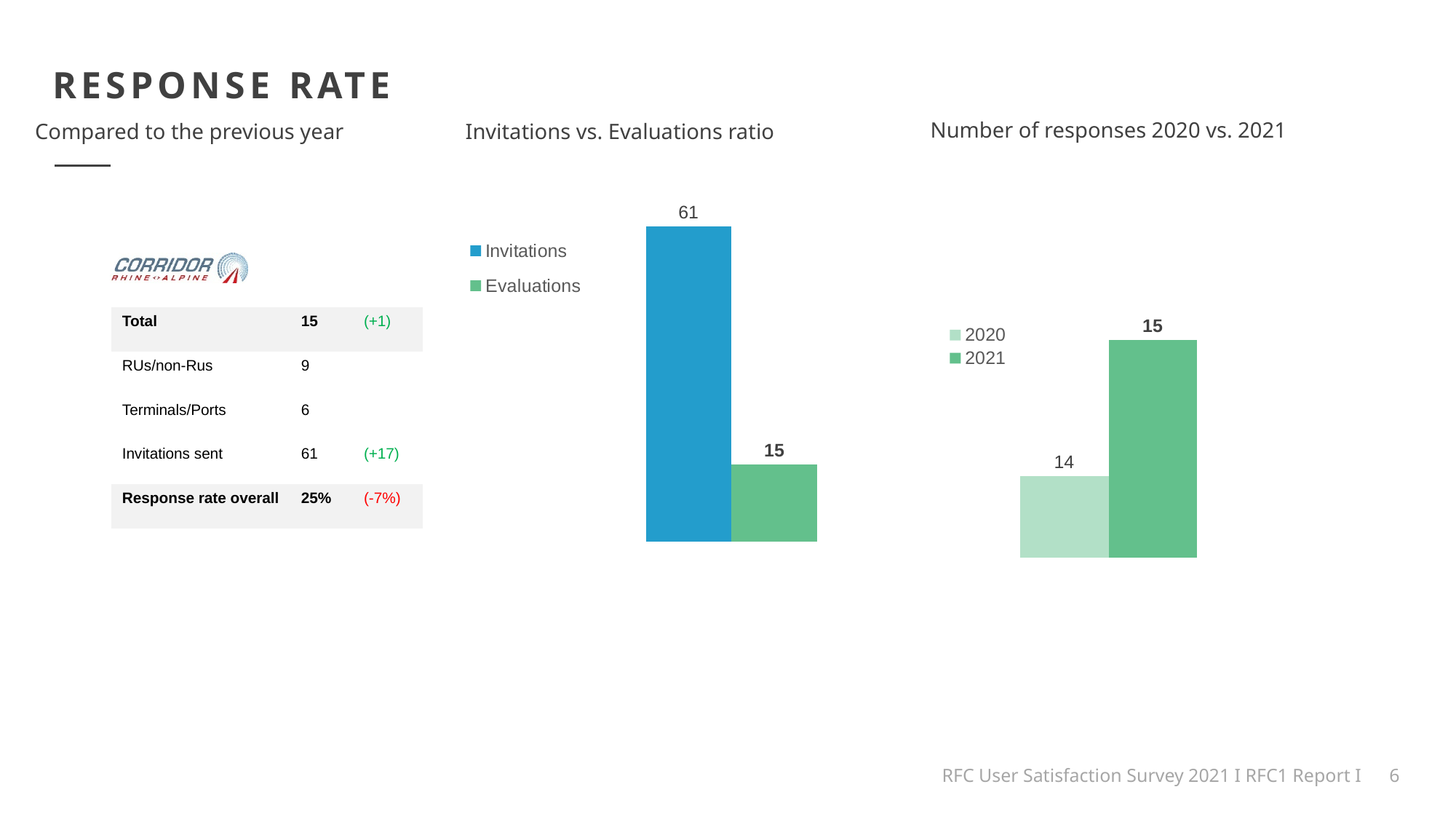
In the 'Number of responses 2020 vs. 2021' chart, which year has the lower number of responses? 2020 In the 'Invitations vs. Evaluations ratio' chart, what colour is the Invitations bar? Blue In the 'Invitations vs. Evaluations ratio' chart, which series has the higher value? Invitations In the 'Number of responses 2020 vs. 2021' chart, what is the value for 2020? 14 In the 'Number of responses 2020 vs. 2021' chart, what is the value for 2021? 15 In the 'Number of responses 2020 vs. 2021' chart, what is the difference between the 2021 and 2020 values? 1 In the 'Invitations vs. Evaluations ratio' chart, what is the value for Evaluations? 15 In the 'Invitations vs. Evaluations ratio' chart, what is the difference between Invitations and Evaluations? 46 In the 'Invitations vs. Evaluations ratio' chart, what is the value for Invitations? 61 In the 'Number of responses 2020 vs. 2021' chart, how many series does the legend list? 2 What kind of chart is the 'Invitations vs. Evaluations ratio' chart? Bar chart In the 'Invitations vs. Evaluations ratio' chart, how many series does the legend list? 2